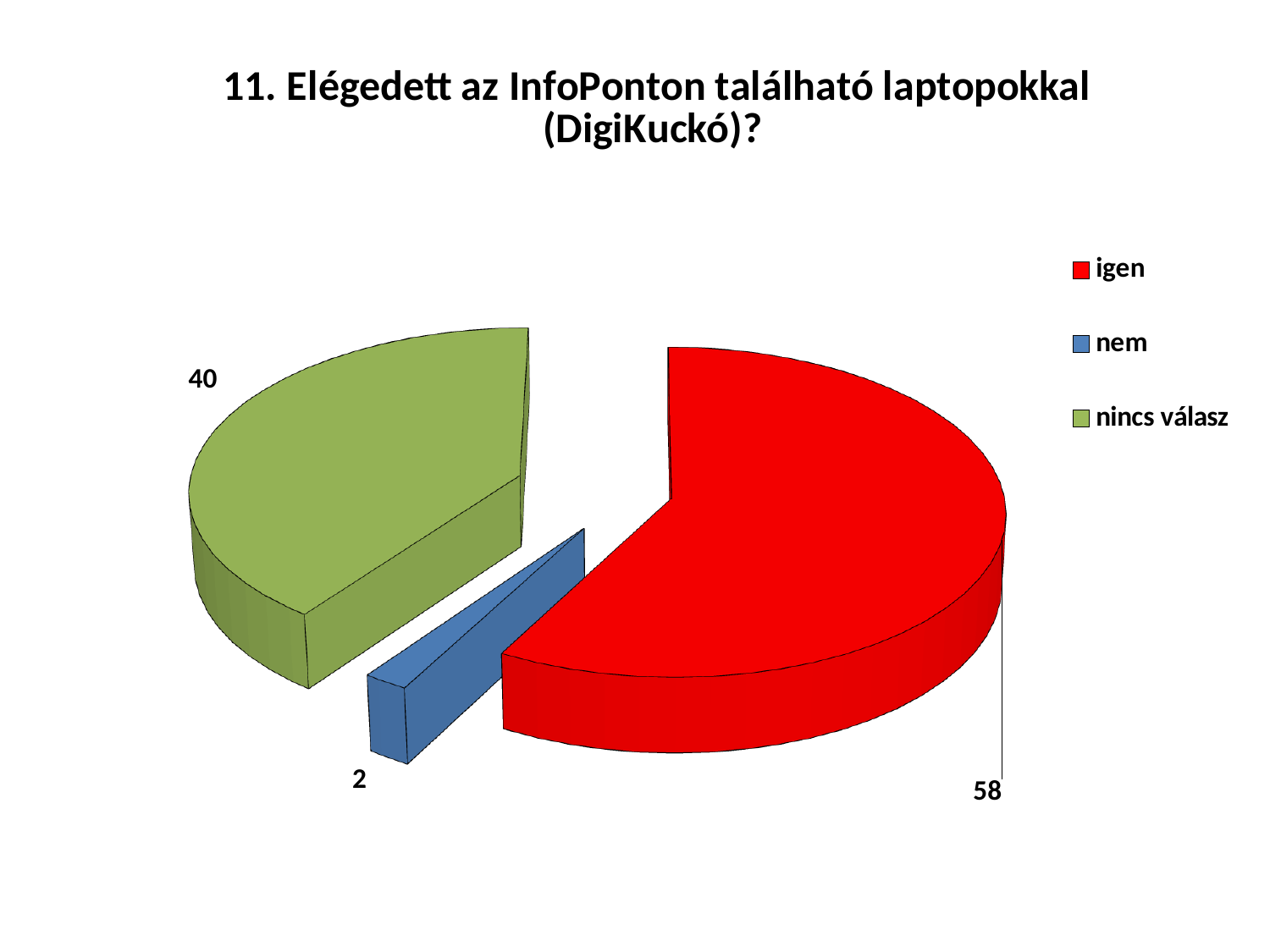
Which category has the largest slice? igen What is the total of all slices in the pie chart? 100 What is the value for "nincs válasz"? 40 How many slices does the pie chart have? 3 Which category has the smallest slice? nem What is the value for "igen"? 58 What is the value for "nem"? 2 What is the difference between the values for "igen" and "nincs válasz"? 18 What share of the pie does the "igen" slice represent? 58% Which colour represents "nincs válasz" in the legend? green Which is larger, the value for "nincs válasz" or the value for "nem"? nincs válasz What type of chart is shown on the slide? pie chart